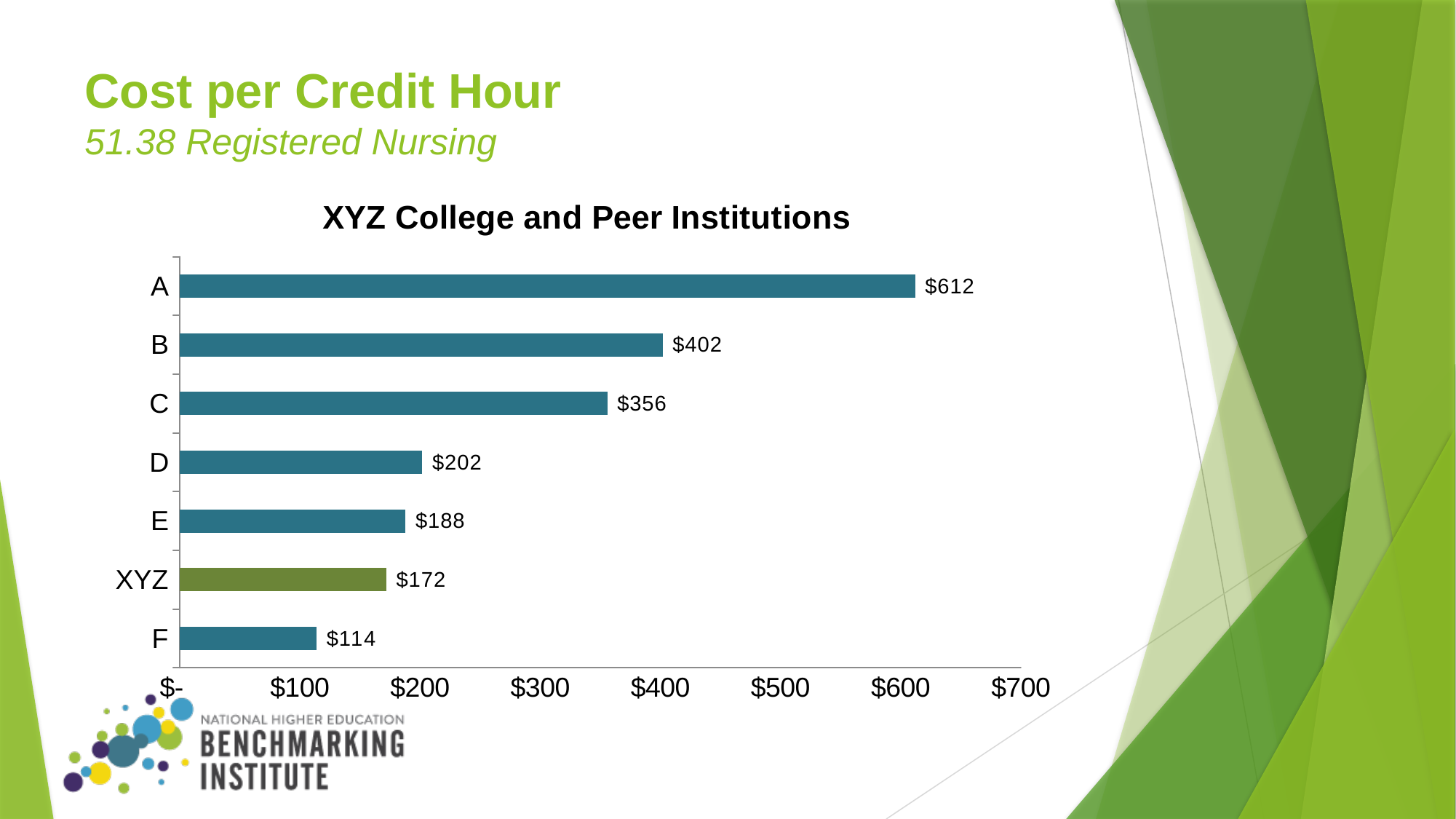
Which institution has the lowest cost per credit hour? F What is the difference in cost per credit hour between institution A and institution B? $210 What is the cost per credit hour for institution A? $612 Is the value for institution B greater or less than $400? greater Which institution has the highest cost per credit hour? A What type of chart is shown on the slide? Bar chart Which has a higher cost per credit hour, institution C or institution E? C How many institutions are shown in the chart? 7 What is the cost per credit hour for institution D? $202 What is the difference in cost per credit hour between XYZ and institution F? $58 What is the cost per credit hour for XYZ? $172 What is the title of the chart? XYZ College and Peer Institutions